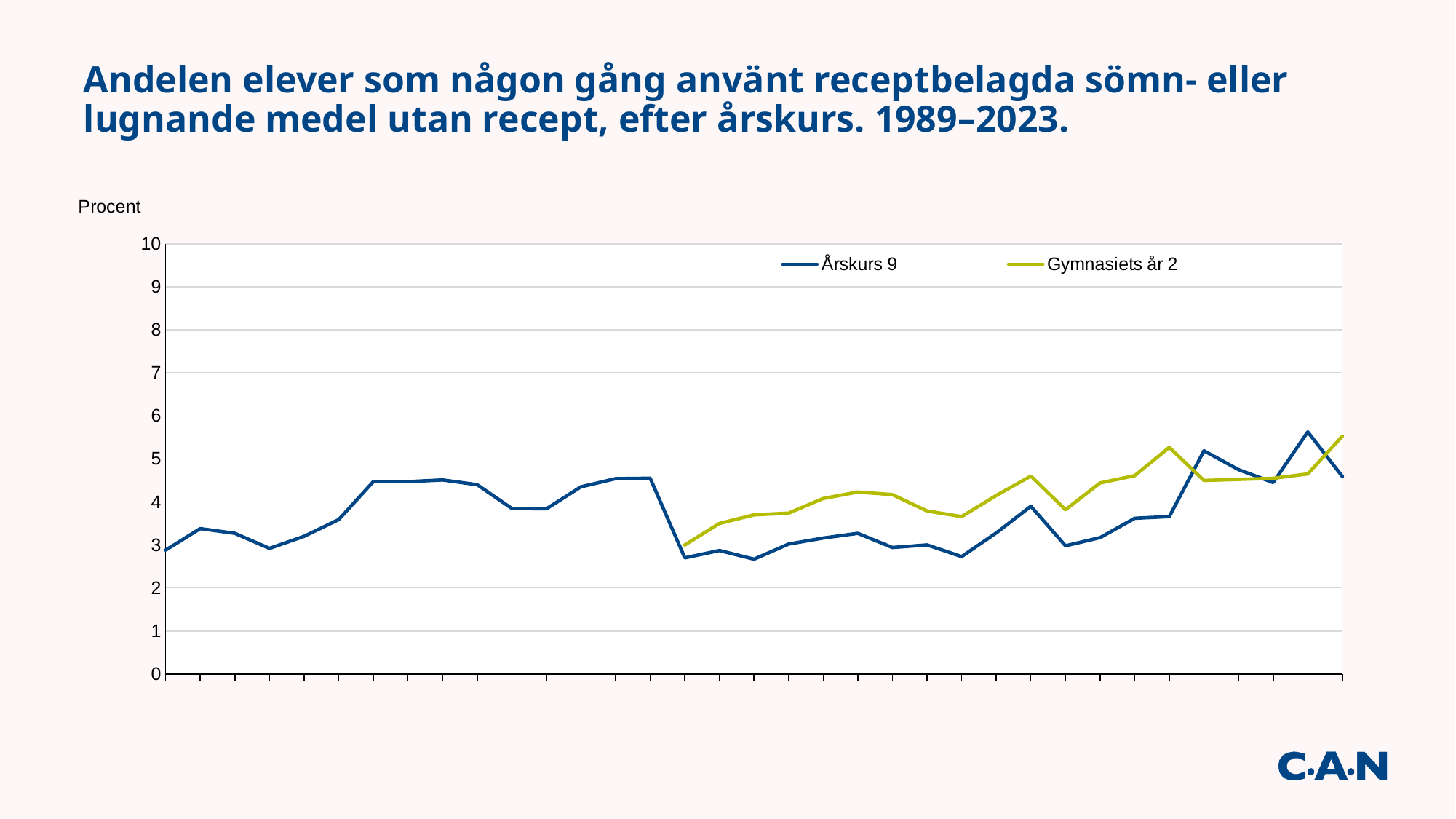
Is the lowest value of the Gymnasiets år 2 line greater or less than 4? less At the last point on the right of the chart, which series is higher, Årskurs 9 or Gymnasiets år 2? Gymnasiets år 2 Is the lowest value of the Årskurs 9 line greater or less than 2? greater What kind of chart is shown on the slide? line chart Is the highest value reached by the Årskurs 9 line greater or less than 5? greater How many series does the legend list? 2 Does the Årskurs 9 line overall rise or fall from its first point to its last point? rise What are the two series named in the legend? Årskurs 9 and Gymnasiets år 2 Does the Gymnasiets år 2 line overall rise or fall from its first point to its last point? rise What label is shown on the vertical axis of the chart? Procent